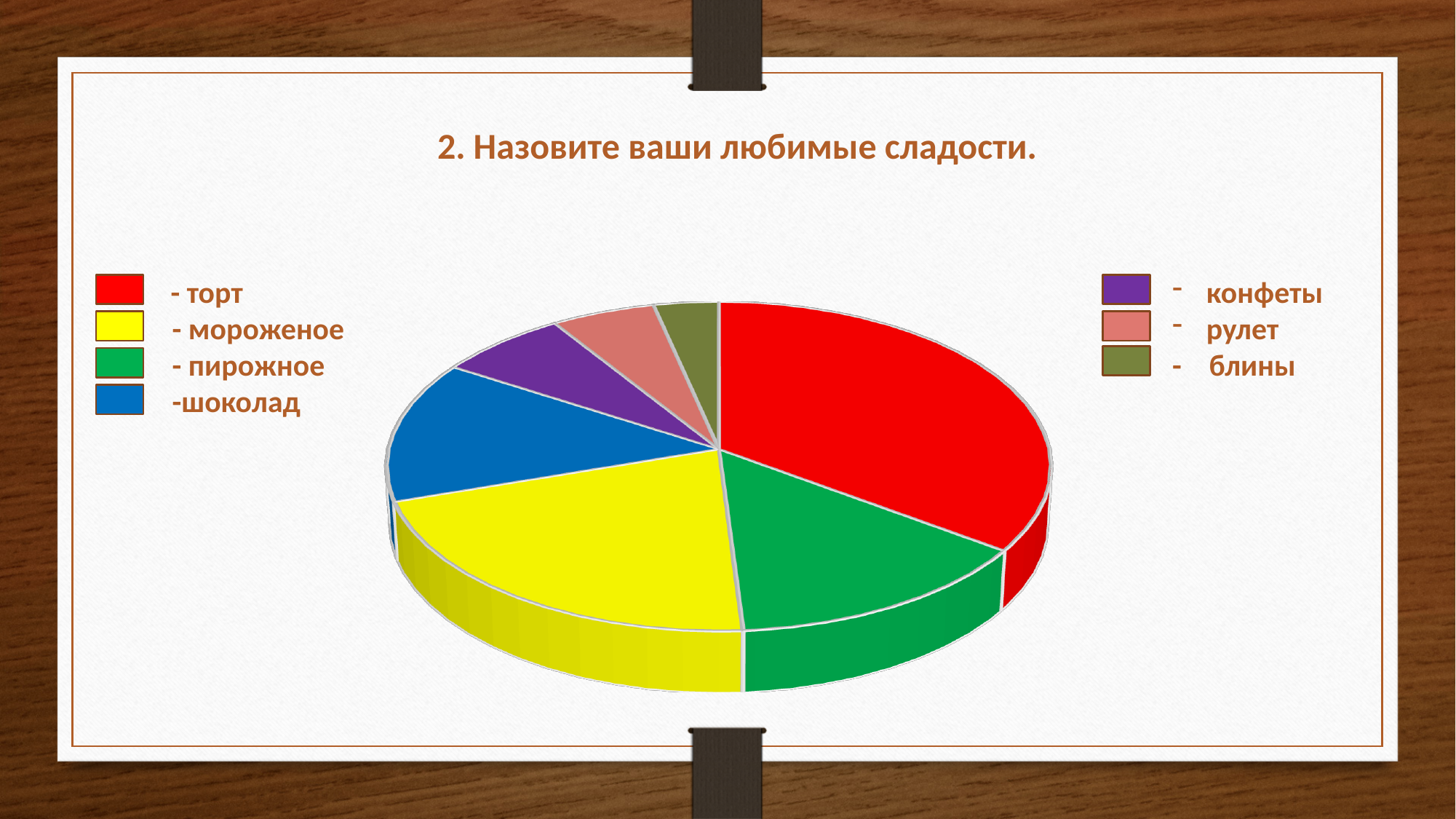
Which is larger in the pie chart, пирожное or рулет? пирожное What colour represents торт in the pie chart? red Which is larger in the pie chart, мороженое or пирожное? мороженое What is the title of the slide above the pie chart? 2. Назовите ваши любимые сладости. How many categories (slices) does the pie chart have? 7 Which is larger in the pie chart, торт or блины? торт Which category has the largest slice of the pie chart? торт What kind of chart is shown on the slide? pie chart